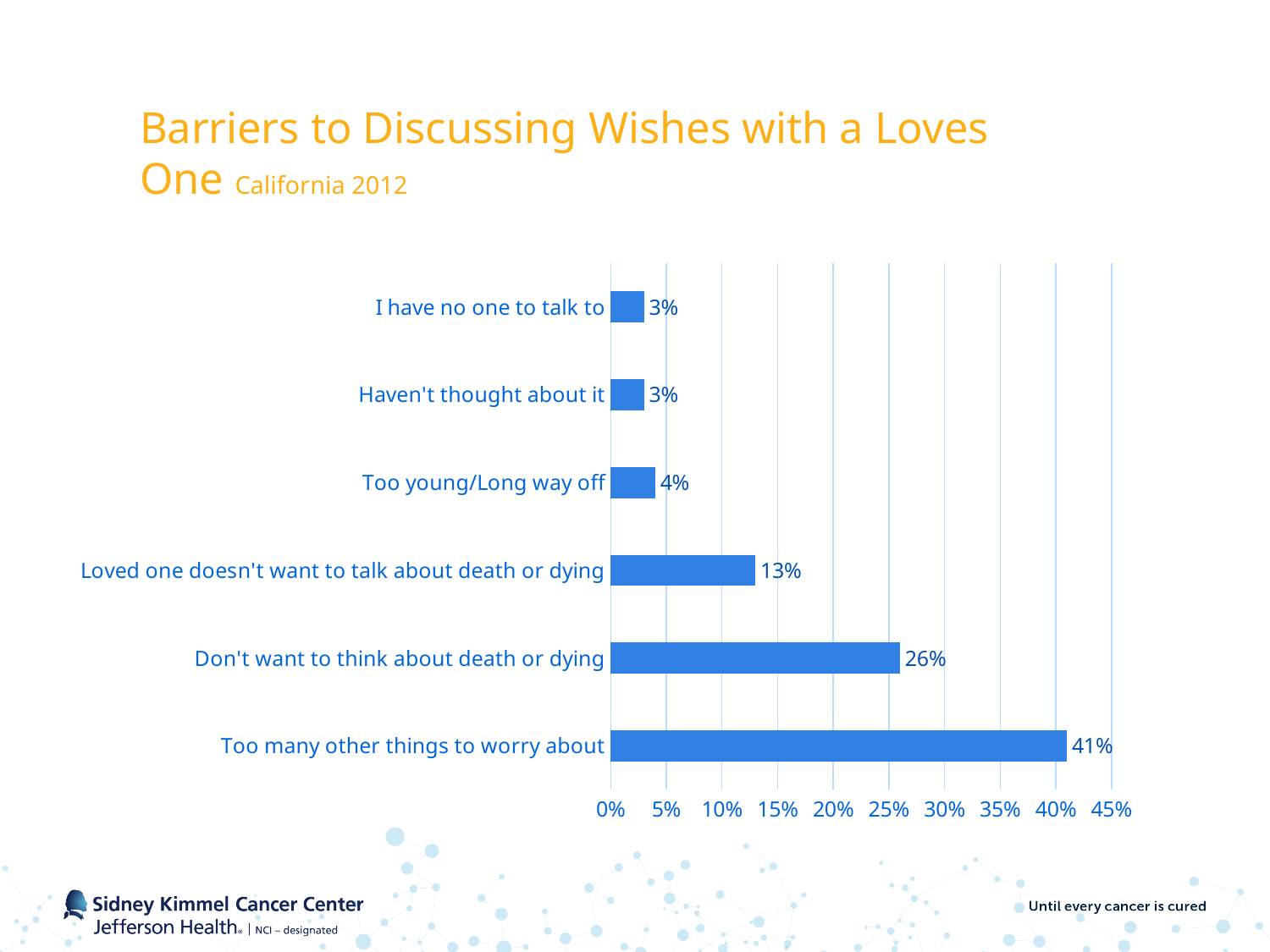
What is the value for "Don't want to think about death or dying"? 26% What is the value for "Too young/Long way off"? 4% What is the maximum value shown on the horizontal axis? 45% Is the value for "Too many other things to worry about" greater or less than 40%? greater What percentage is shown for "Loved one doesn't want to talk about death or dying"? 13% How many barriers are shown in the chart? 6 What is the difference between "Don't want to think about death or dying" and "Loved one doesn't want to talk about death or dying"? 13% What percentage is shown for "Too many other things to worry about"? 41% What is the difference between "Too many other things to worry about" and "Don't want to think about death or dying"? 15% What type of chart is shown on the slide? Bar chart Which is larger: "Too young/Long way off" or "Loved one doesn't want to talk about death or dying"? Loved one doesn't want to talk about death or dying Which barrier has the highest percentage? Too many other things to worry about